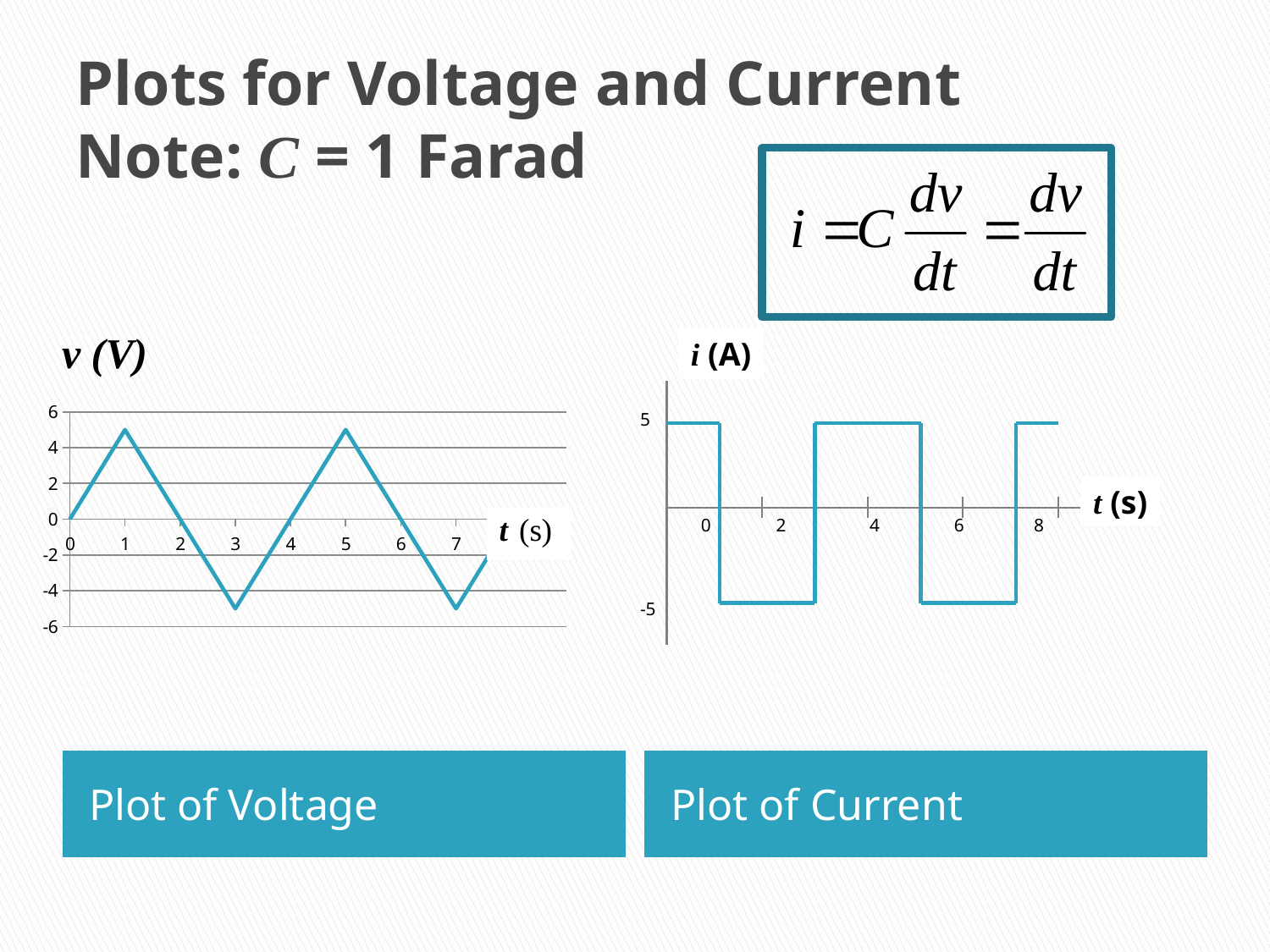
In the Plot of Voltage, is the voltage at t = 1 s greater or less than 4? greater In the Plot of Voltage, what is the voltage at t = 2 s? 0 What kind of chart is the Plot of Current? line chart In the Plot of Current, what is the current at t = 2 s? -5 In the Plot of Voltage, is the voltage at t = 3 s greater or less than -4? less In the Plot of Voltage, which is larger: the voltage at t = 1 s or at t = 3 s? t = 1 s In the Plot of Voltage, does the voltage rise or fall between t = 0 s and t = 1 s? rise What is the label on the vertical axis of the Plot of Current? i (A) What kind of chart is the Plot of Voltage? line chart In the Plot of Current, what is the current at t = 4 s? 5 In the Plot of Voltage, what is the voltage at t = 0 s? 0 In the Plot of Current, which is larger: the current at t = 2 s or at t = 4 s? t = 4 s